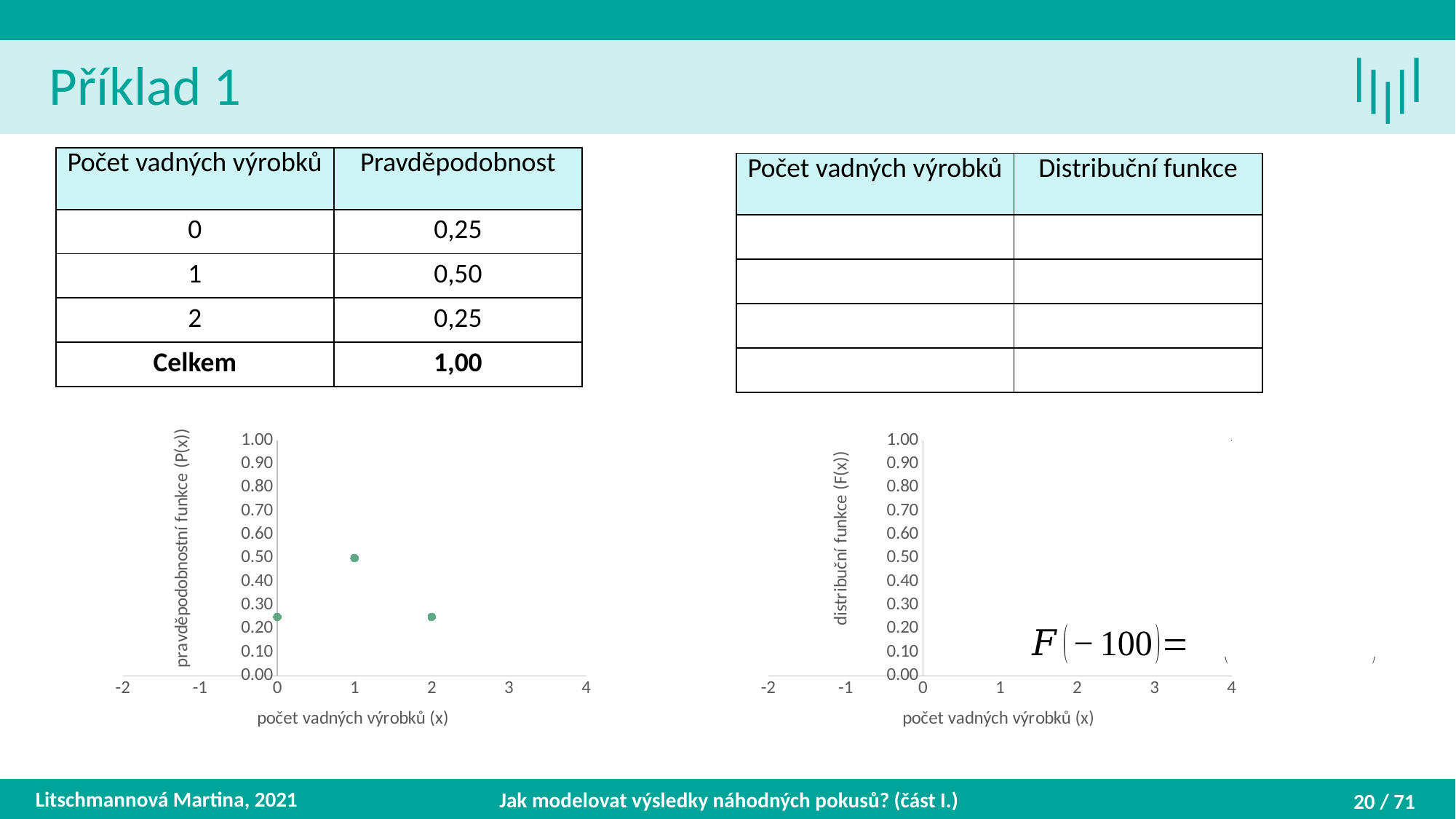
On the left chart, which has the larger value: x = 1 or x = 2? x = 1 On the left chart, do the values rise or fall from x = 1 to x = 2? fall On the left chart, what kind of chart is it? scatter chart On the left chart, how many data points are plotted? 3 On the right chart, what is the title of the y axis? distribuční funkce (F(x)) On the left chart, what is the value of the probability function at x = 1? 0.50 On the left chart, is the value at x = 1 greater or less than 0.40? greater On the left chart, at which value of x is the probability function highest? 1 On the left chart, what is the title of the x axis? počet vadných výrobků (x) On the left chart, is the value at x = 2 greater or less than 0.20? greater On the left chart, is the value at x = 0 greater or less than 0.30? less